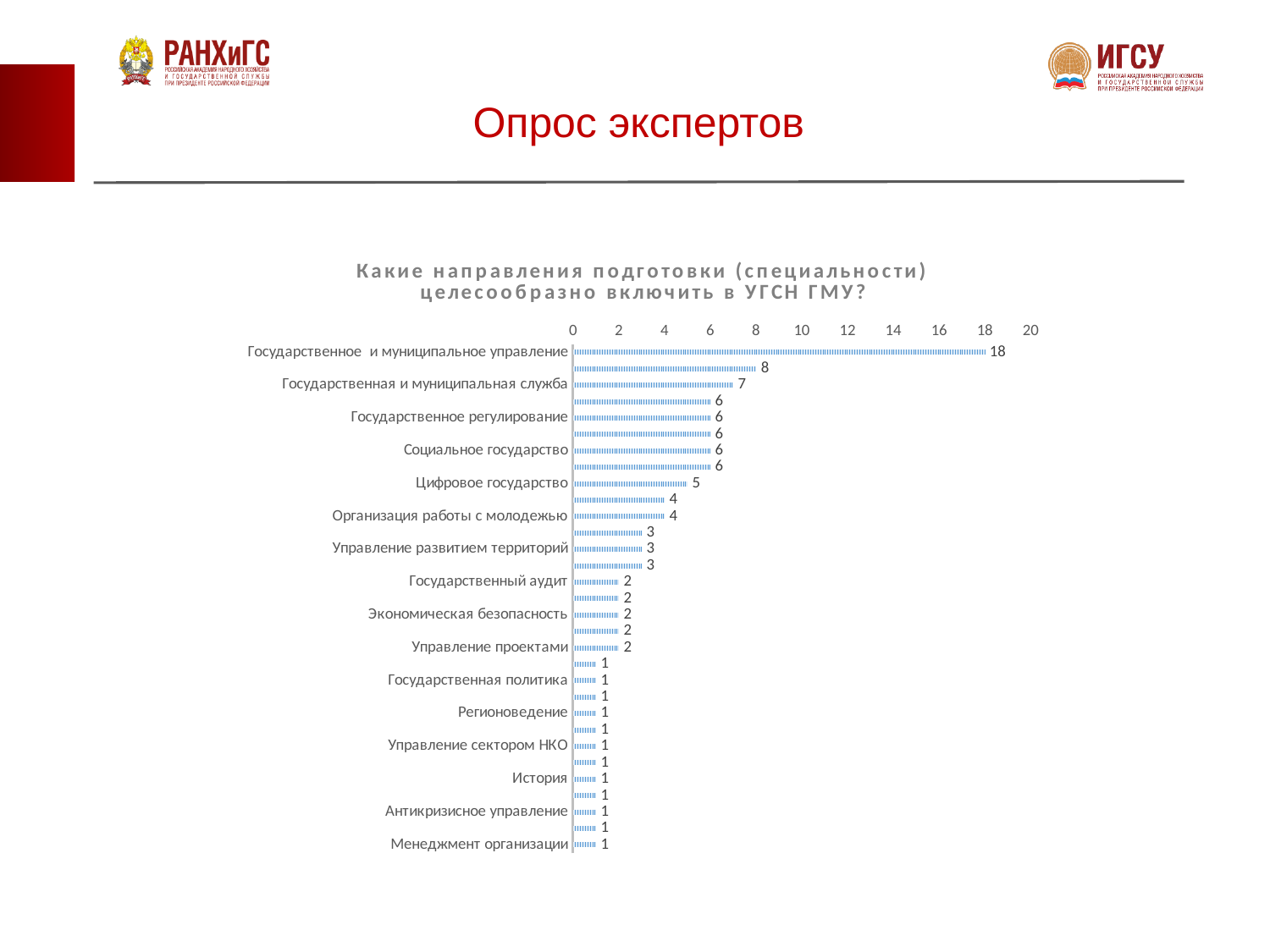
What is the value for Государственная и муниципальная служба? 7 Which category has the highest value? Государственное и муниципальное управление What is the difference between the values for Государственное и муниципальное управление and Государственная и муниципальная служба? 11 Is the value for Государственное и муниципальное управление greater or less than 16? greater What kind of chart is shown on the slide? bar chart What is the value for Менеджмент организации? 1 Which is larger: the value for Цифровое государство or the value for Организация работы с молодежью? Цифровое государство What is the value for Цифровое государство? 5 What is the title of the chart? Какие направления подготовки (специальности) целесообразно включить в УГСН ГМУ? What is the value for Государственное и муниципальное управление? 18 What is the value for Организация работы с молодежью? 4 What is the value for Управление развитием территорий? 3